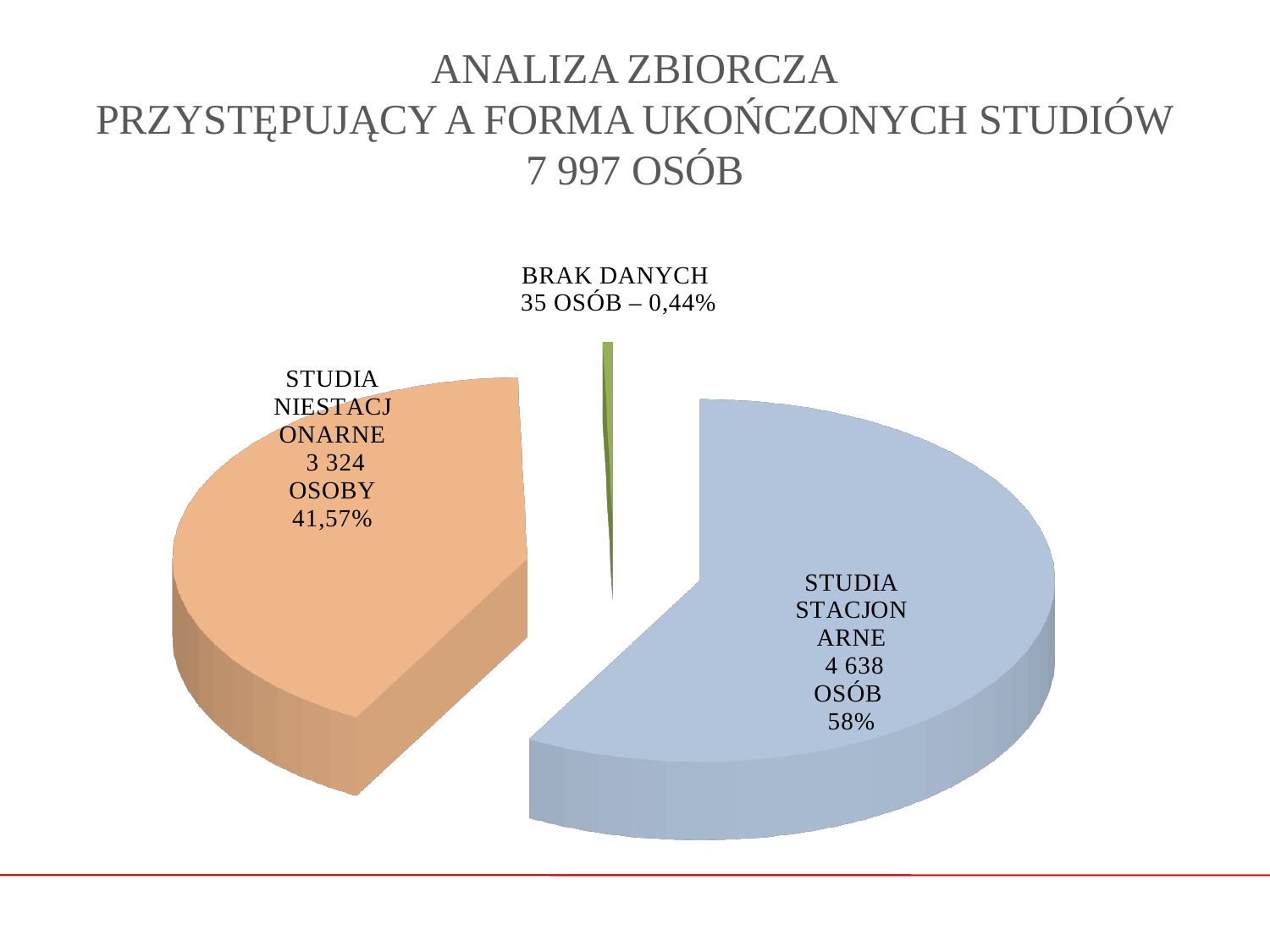
What share of the pie does STUDIA NIESTACJONARNE represent? 41,57% What is the difference in number of people between STUDIA STACJONARNE and STUDIA NIESTACJONARNE? 1 314 What total number of people is stated in the chart title? 7 997 How many people are in the STUDIA STACJONARNE slice? 4 638 How many people are in the STUDIA NIESTACJONARNE slice? 3 324 Which slice of the pie chart is the smallest? BRAK DANYCH What share of the pie does STUDIA STACJONARNE represent? 58% Which slice of the pie chart is the largest? STUDIA STACJONARNE How many slices does the pie chart have? 3 How many people are in the BRAK DANYCH slice? 35 What kind of chart is shown on the slide? pie chart What share of the pie does BRAK DANYCH represent? 0,44%